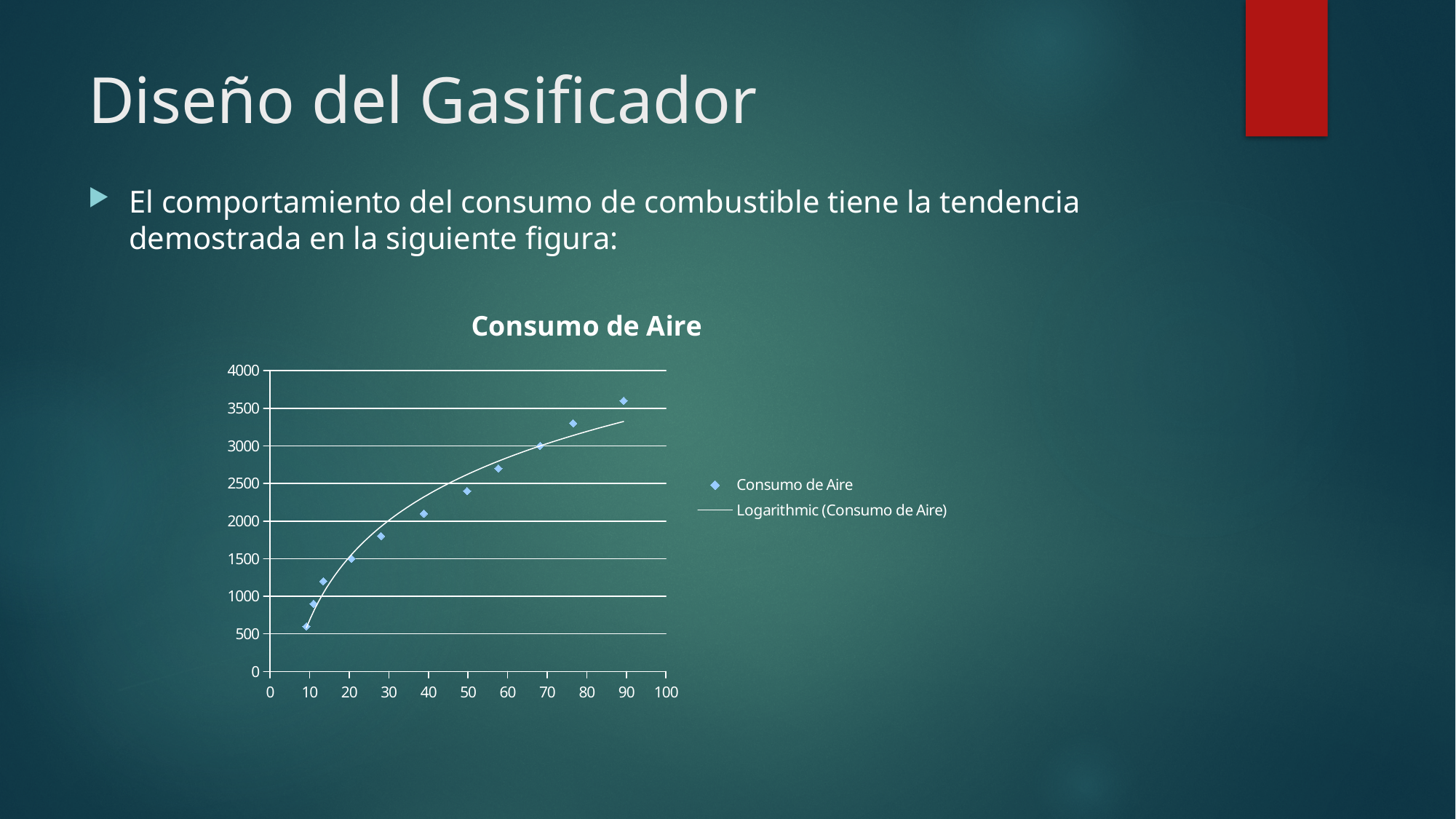
Is the lowest plotted Consumo de Aire point greater or less than 1000? less How many data points are plotted in the Consumo de Aire series? 11 Do the Consumo de Aire values rise or fall as the x-axis value increases? rise What is the name of the trendline entry in the legend? Logarithmic (Consumo de Aire) Is the plotted point near x = 30 greater or less than 1500? greater What is the title of the chart? Consumo de Aire Is the highest plotted Consumo de Aire point greater or less than 3500? greater What kind of chart is shown on the slide? scatter chart What is the maximum value shown on the y-axis? 4000 How many entries does the chart legend list? 2